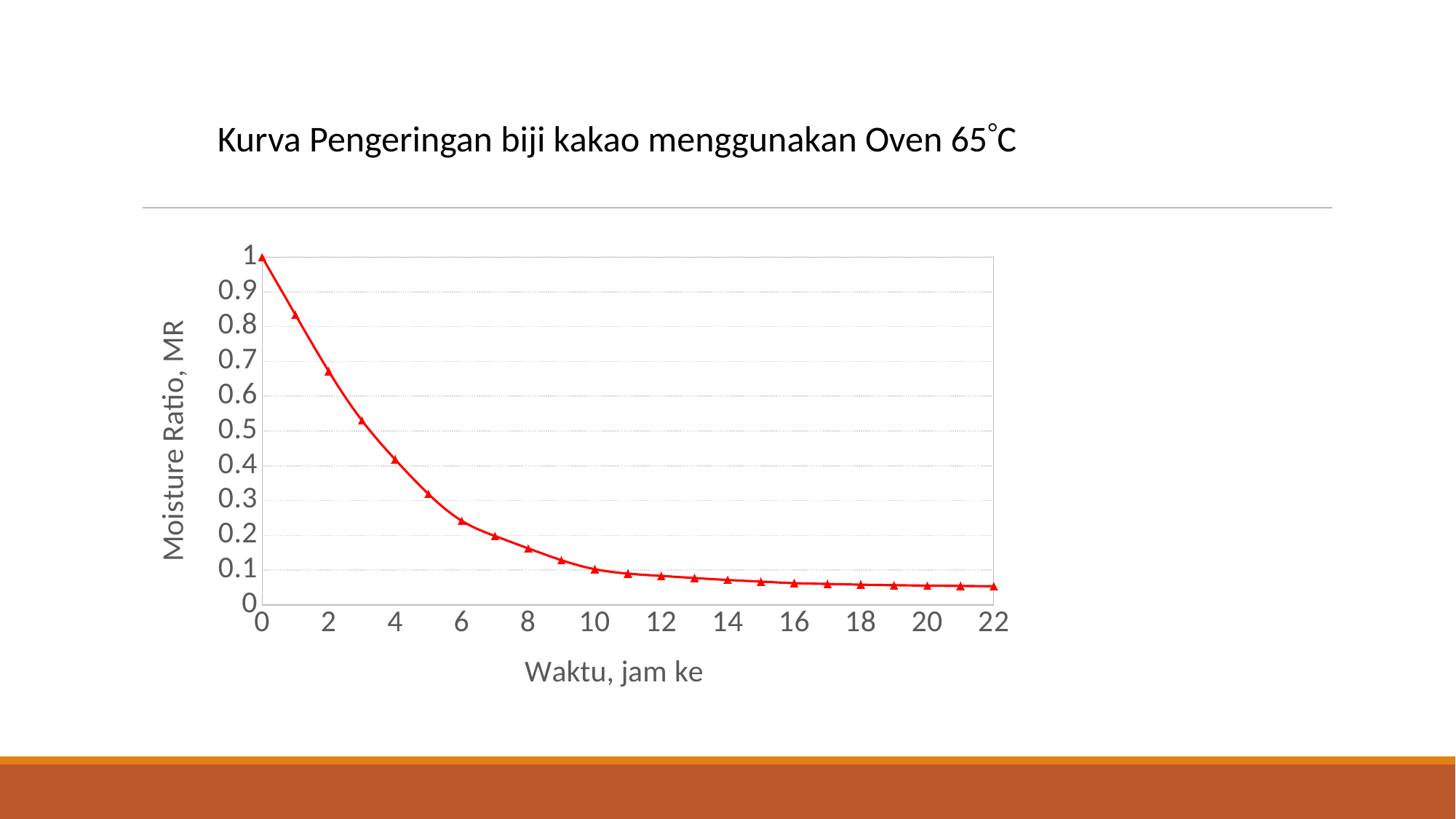
Is the Moisture Ratio at hour 4 greater or less than 0.5? less Is the Moisture Ratio at hour 12 greater or less than 0.1? less Is the Moisture Ratio at hour 2 greater or less than 0.6? greater What is the title of the chart? Kurva Pengeringan biji kakao menggunakan Oven 65°C Do the Moisture Ratio values rise or fall as time (Waktu, jam ke) increases? fall What is the Moisture Ratio (MR) at hour 0? 1 At which hour is the Moisture Ratio highest? 0 Which has the larger Moisture Ratio, hour 2 or hour 8? hour 2 What kind of chart is shown on the slide? line chart How many data points are plotted on the curve? 23 What is the label of the x axis? Waktu, jam ke